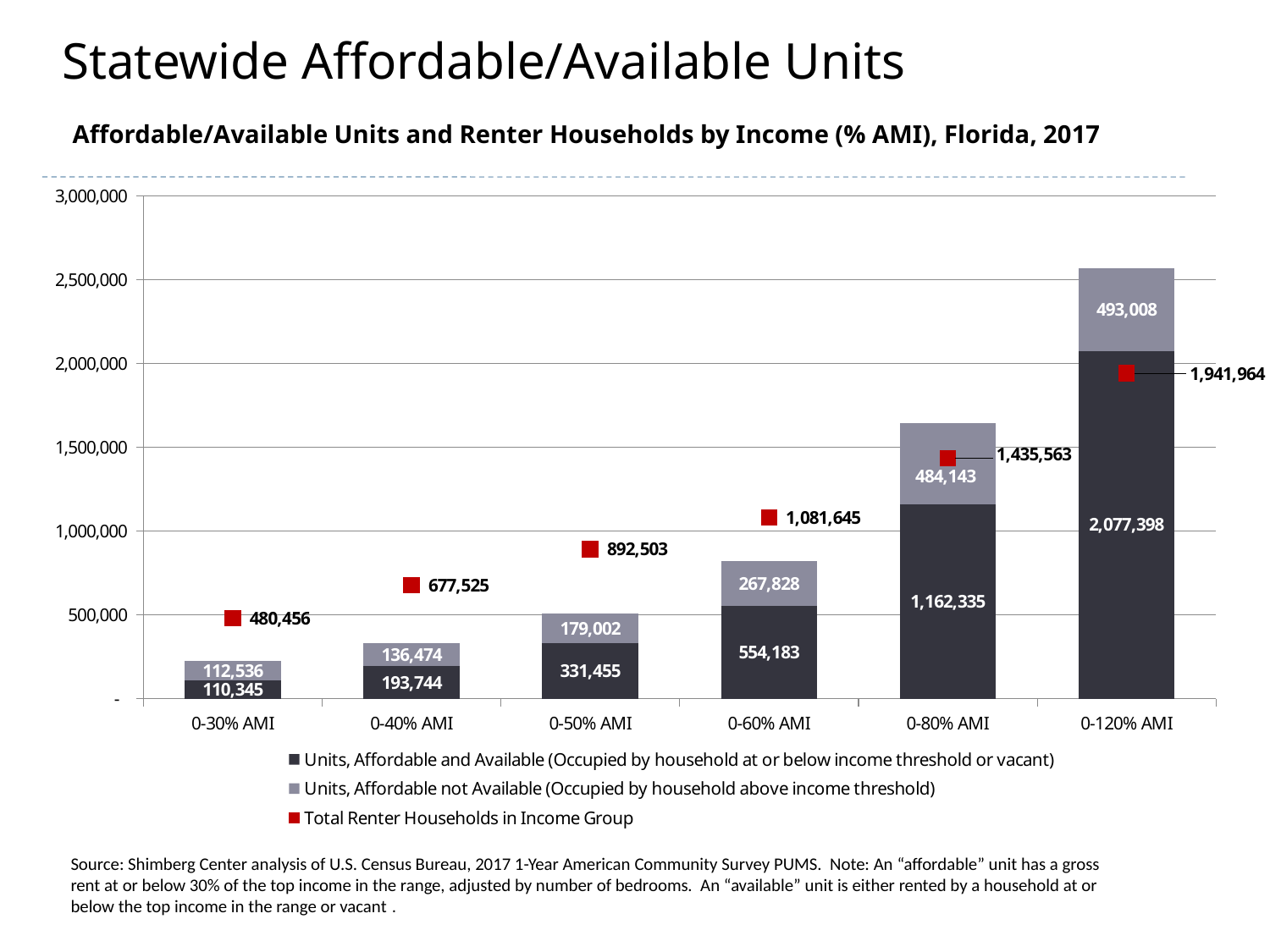
How many series does the legend list? 3 Do the Total Renter Households in Income Group values rise or fall from 0-30% AMI to 0-120% AMI? Rise What is the value of Units, Affordable not Available for 0-80% AMI? 484,143 Which is larger for 0-30% AMI: Units, Affordable and Available or Units, Affordable not Available? Units, Affordable not Available What is the difference between the Units, Affordable and Available values for 0-120% AMI and 0-80% AMI? 915,063 What is the Total Renter Households in Income Group value for 0-50% AMI? 892,503 What is the total height of the stacked bar for 0-50% AMI? 510,457 How many income groups are shown on the x axis? 6 Which income group has the highest value for Units, Affordable and Available? 0-120% AMI What kind of chart is this? Stacked bar chart What is the value of Units, Affordable and Available for 0-60% AMI? 554,183 Which income group has the lowest Total Renter Households in Income Group value? 0-30% AMI